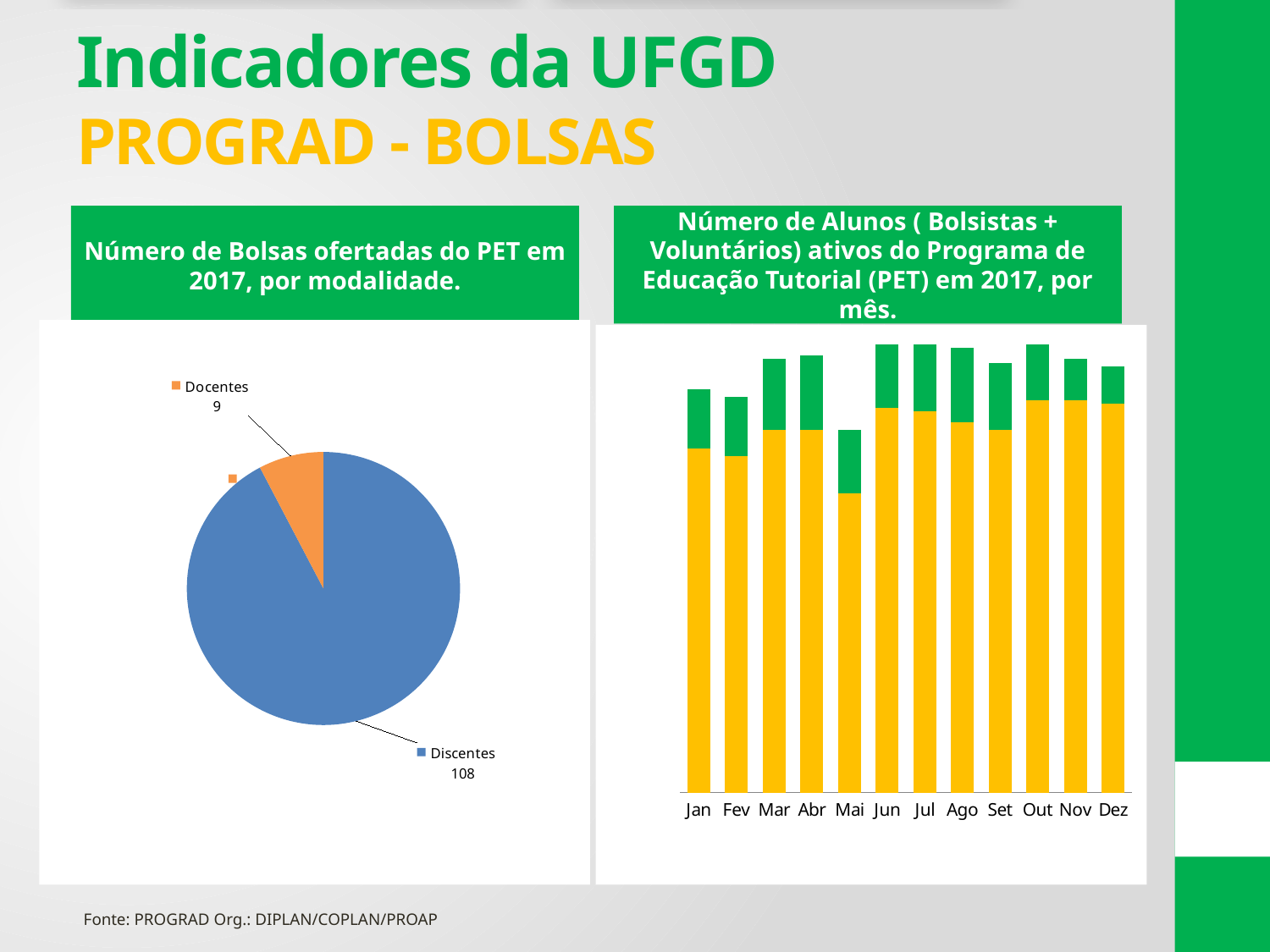
How many slices does the pie chart on the left have? 2 In the pie chart on the left, what is the total of the two categories? 117 In the pie chart 'Número de Bolsas ofertadas do PET em 2017, por modalidade', what is the value for Discentes? 108 How many months are shown on the x axis of the bar chart on the right? 12 In the bar chart on the right, which month has the lowest total bar? Mai In the pie chart on the left, what is the difference between the Discentes and Docentes values? 99 In the bar chart on the right, which month has the larger total bar, Jan or Mai? Jan What kind of chart is the chart on the left of the slide? Pie chart In the pie chart on the left, which category has the largest slice? Discentes In the pie chart 'Número de Bolsas ofertadas do PET em 2017, por modalidade', what is the value for Docentes? 9 What kind of chart is the chart on the right of the slide, 'Número de Alunos (Bolsistas + Voluntários) ativos do Programa de Educação Tutorial (PET) em 2017, por mês'? Bar chart In the pie chart on the left, which category has the smallest slice? Docentes